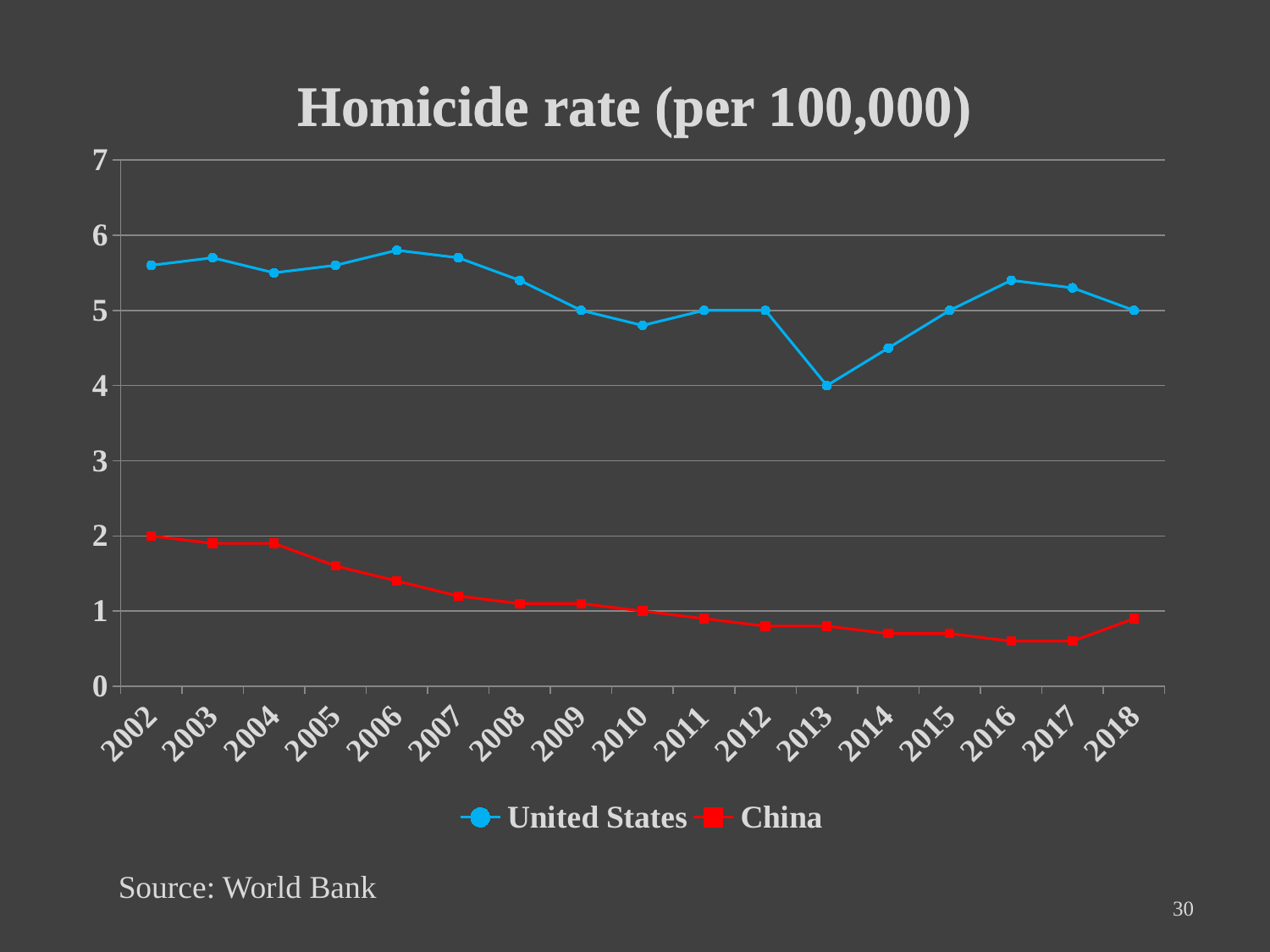
Is the value for China in 2006 greater or less than 2? less How many years are plotted along the x axis? 17 Does the homicide rate for China generally rise or fall from 2002 to 2017? fall What is the homicide rate for the United States in 2013? 4 What is the homicide rate for China in 2002? 2 What kind of chart is shown on the slide? line chart In which year is the United States homicide rate highest? 2006 What is the title of the chart? Homicide rate (per 100,000) How many series does the legend list? 2 What is the homicide rate for China in 2010? 1 Which series has the higher homicide rate in 2018, United States or China? United States In which year is the United States homicide rate lowest? 2013